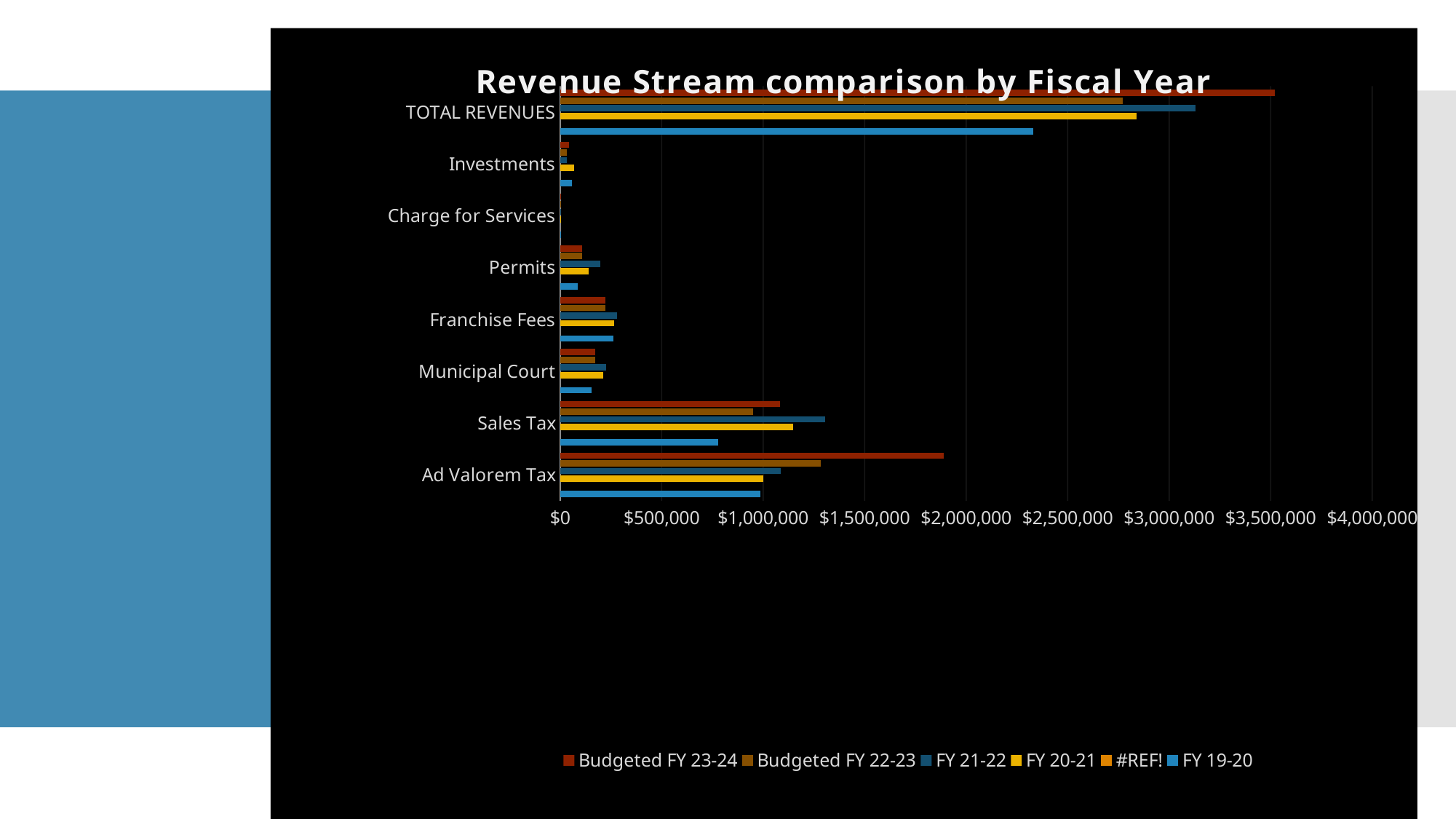
Is the FY 19-20 value for Sales Tax greater or less than $1,000,000? less What kind of chart is shown on the slide? Bar chart Is the FY 19-20 value for TOTAL REVENUES greater or less than $2,000,000? greater Is the Budgeted FY 23-24 value for TOTAL REVENUES greater or less than $3,000,000? greater What is the title of the chart? Revenue Stream comparison by Fiscal Year How many revenue categories are shown on the vertical axis? 8 Which revenue category has the lowest values across all fiscal years? Charge for Services For Ad Valorem Tax, which is larger: the Budgeted FY 23-24 value or the Budgeted FY 22-23 value? Budgeted FY 23-24 How many series does the legend list? 6 Excluding TOTAL REVENUES, which revenue category has the highest Budgeted FY 23-24 value? Ad Valorem Tax